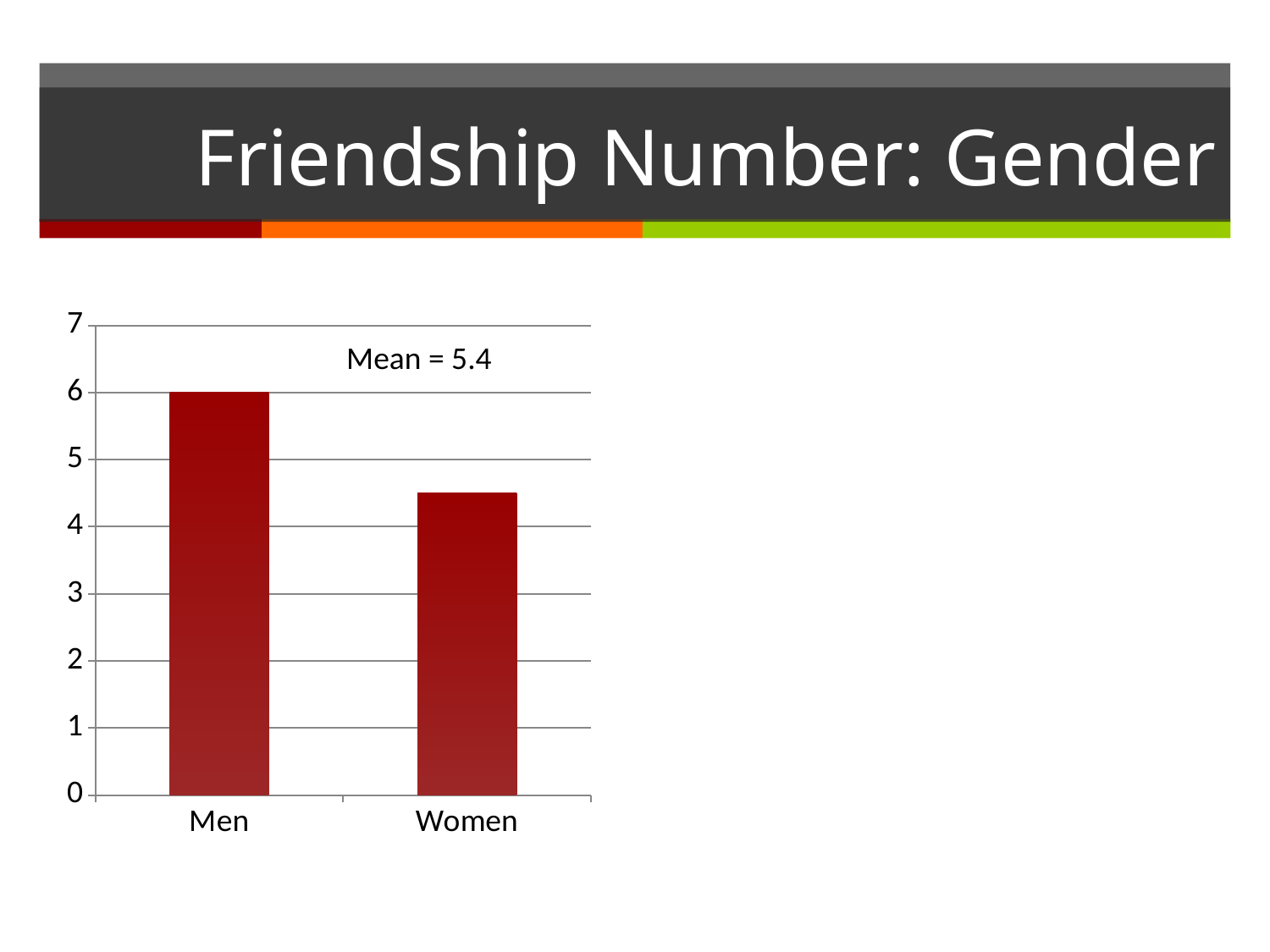
Which category has the lowest value in the chart? Women Is the value for Men greater or less than 5? greater Do the values rise or fall from Men to Women along the x axis? fall What kind of chart is shown on the slide? bar chart Is the value for Women greater or less than 5? less What mean value is annotated on the chart? Mean = 5.4 Which category has the highest value in the chart? Men How many categories are shown on the x axis of the chart? 2 What is the title of the slide containing the chart? Friendship Number: Gender What is the value for Men in the chart? 6 Which is larger, the value for Men or the value for Women? Men Is the value for Women greater or less than 4? greater